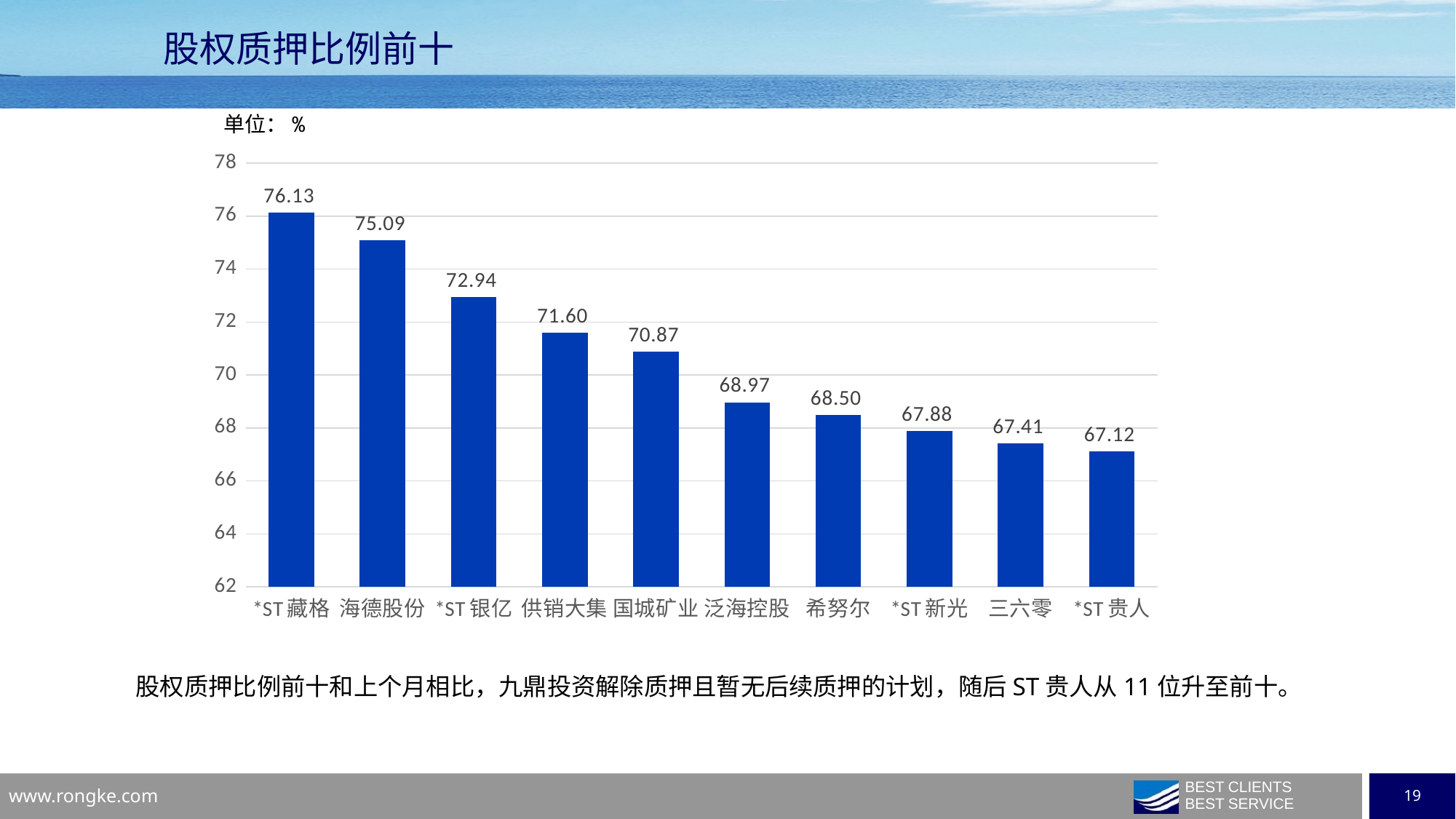
What kind of chart is shown on the slide? bar chart What is the difference between the values for *ST 藏格 and *ST 贵人? 9.01 Do the values rise or fall from left to right along the x axis? fall What is the value for 国城矿业? 70.87 What is the difference between the values for 供销大集 and 泛海控股? 2.63 Which category has the lowest value? *ST 贵人 What is the value for 三六零? 67.41 What is the value for 海德股份? 75.09 Is the value for 泛海控股 greater or less than 70? less Which category has the highest value? *ST 藏格 How many categories are shown in the chart? 10 Which is larger, the value for *ST 银亿 or the value for 希努尔? *ST 银亿